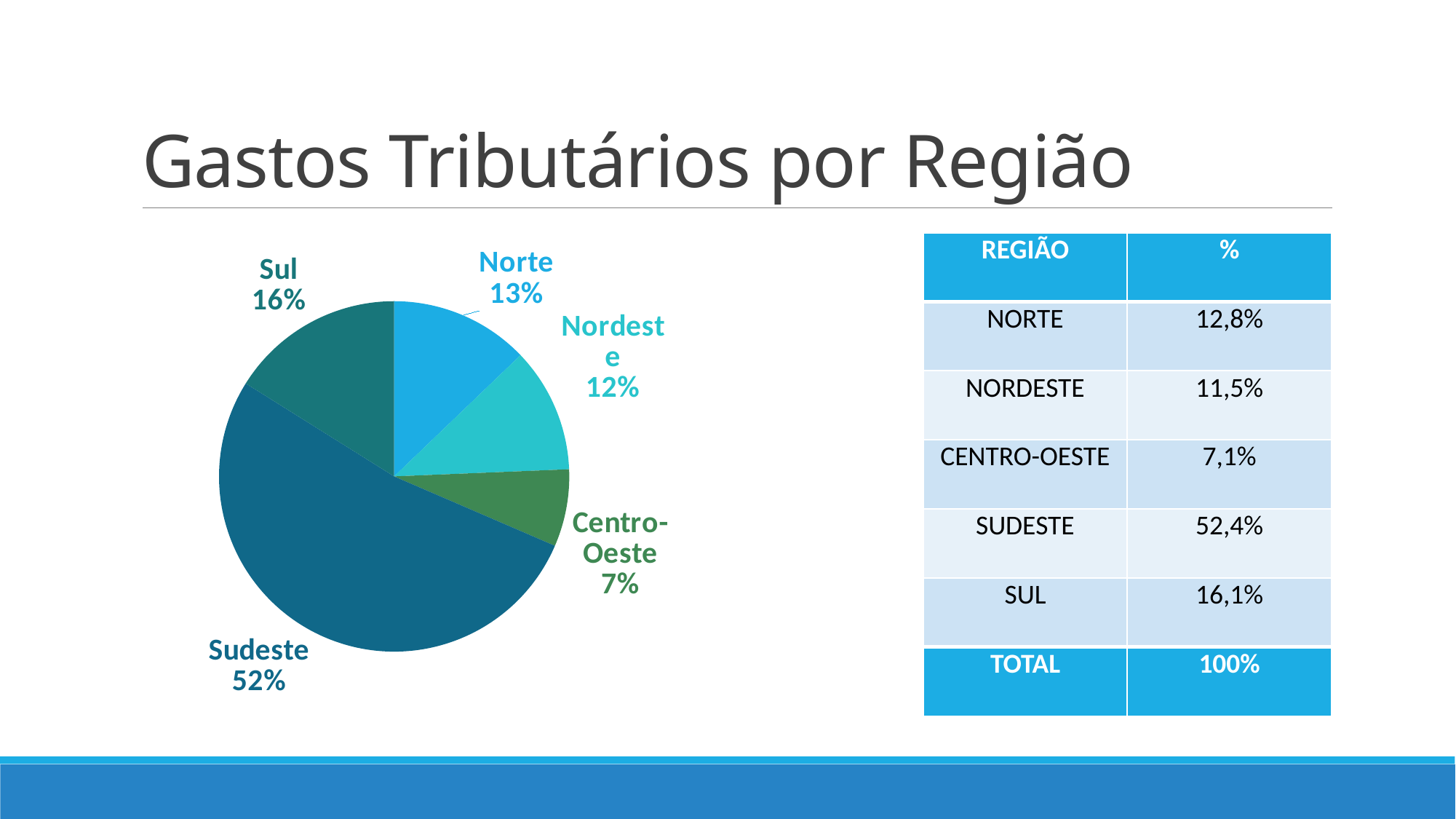
What is the value shown for Sul in the pie chart? 16% What is the difference between the Norte and Centro-Oeste percentages shown in the pie chart? 6% What is the difference between the Sudeste and Sul percentages shown in the pie chart? 36% What is the value shown for Centro-Oeste in the pie chart? 7% Which is larger in the pie chart, Sul or Nordeste? Sul Which region has the smallest slice of the pie chart? Centro-Oeste Which region has the largest slice of the pie chart? Sudeste How many slices does the pie chart have? 5 What is the value shown for Norte in the pie chart? 13% What kind of chart is shown on the slide? pie chart What share of the pie does Sudeste have? 52% What is the title of the slide containing the pie chart? Gastos Tributários por Região